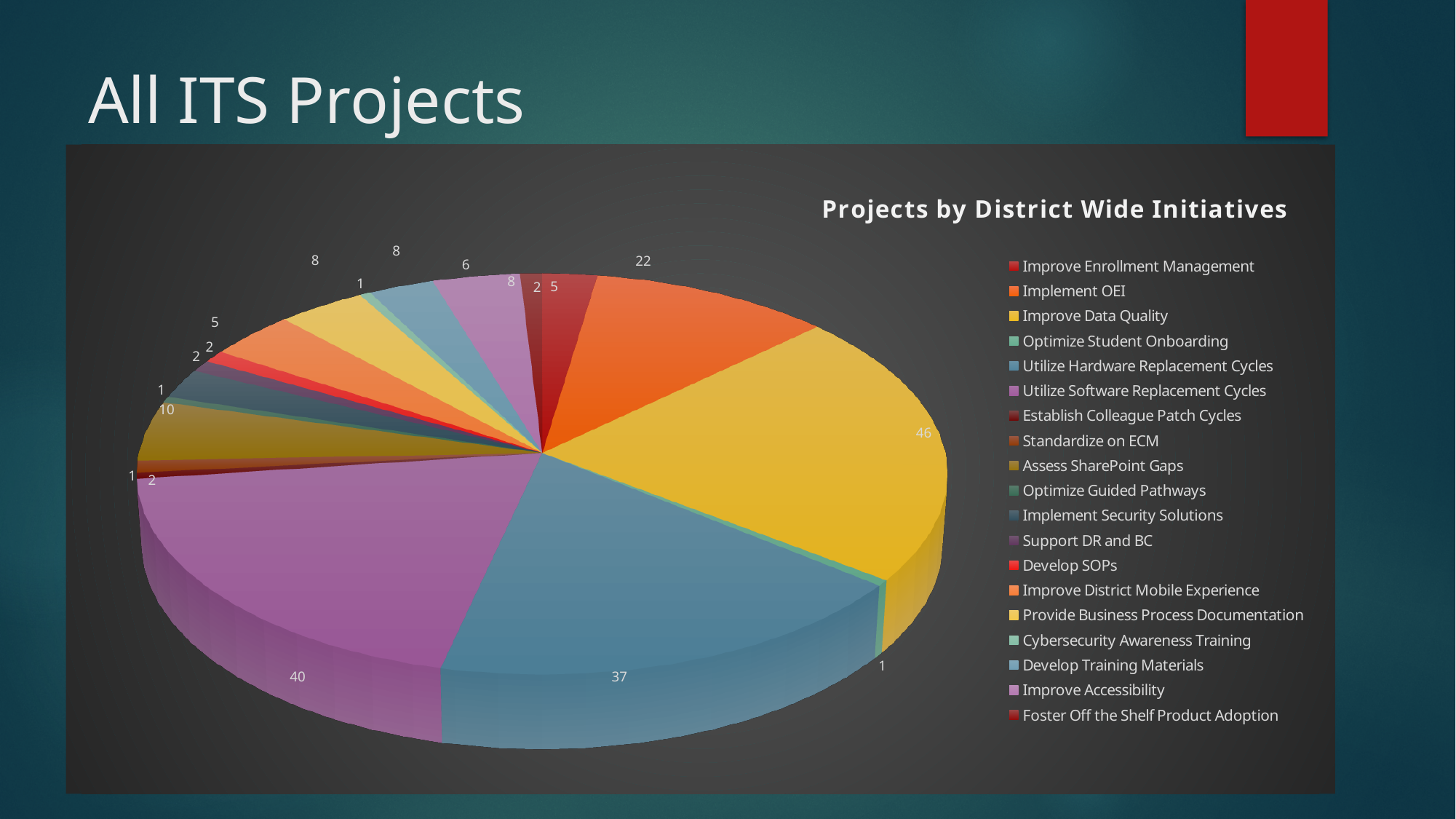
How many projects are shown for Utilize Software Replacement Cycles? 40 What is the difference between the number of projects for Improve Data Quality and Implement OEI? 24 What is the difference between the number of projects for Improve Data Quality and Utilize Software Replacement Cycles? 6 Which initiative has the largest slice of the pie? Improve Data Quality How many projects are shown for Improve Data Quality? 46 How many projects are shown for Assess SharePoint Gaps? 10 How many projects are shown for Implement OEI? 22 Which has more projects, Utilize Software Replacement Cycles or Utilize Hardware Replacement Cycles? Utilize Software Replacement Cycles How many projects are shown for Utilize Hardware Replacement Cycles? 37 What type of chart is shown on the slide? Pie chart What is the title of the chart? Projects by District Wide Initiatives How many initiatives are listed in the chart legend? 19